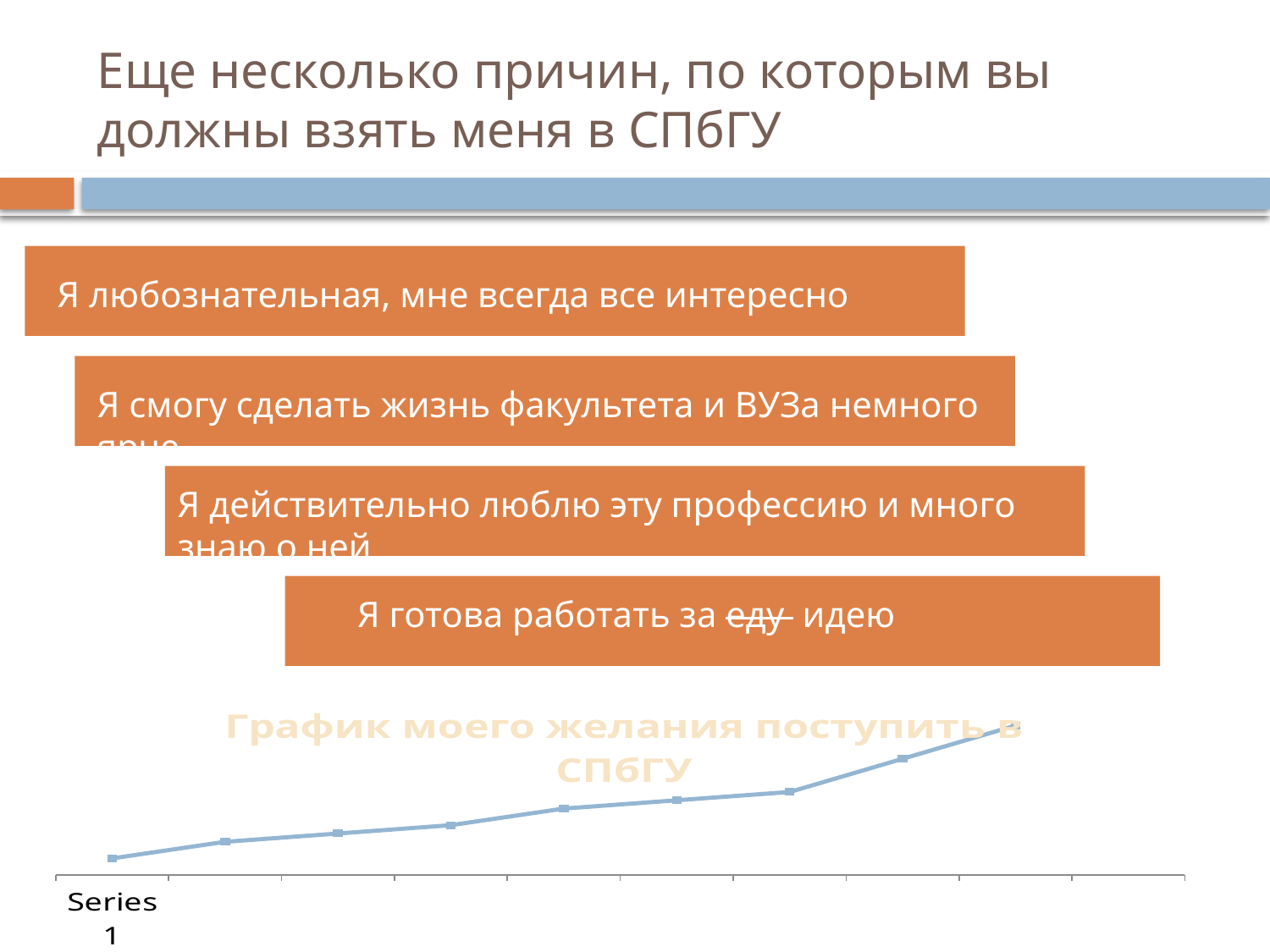
Which point on the line chart is the highest, the leftmost or the rightmost? rightmost Do the values in the line chart rise or fall from left to right? rise How many data points are plotted on the line chart? 9 What colour is the line in the chart? light blue What is the title of the line chart? График моего желания поступить в СПбГУ Which point on the line chart is the lowest, the leftmost or the rightmost? leftmost What kind of chart is shown at the bottom of the slide? line chart